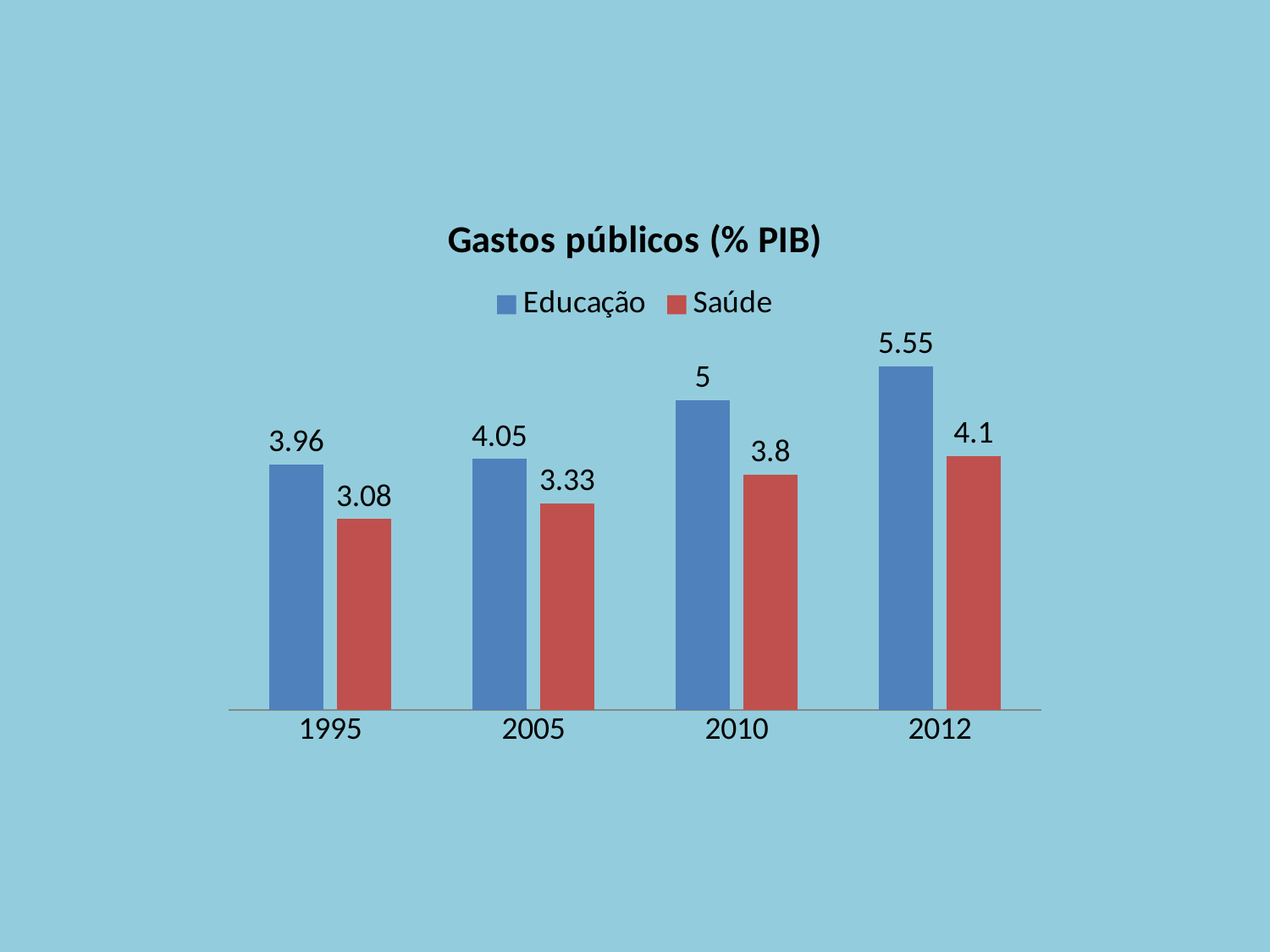
How many series does the legend list? 2 What kind of chart is shown? Bar chart In which year is the Educação value highest? 2012 In which year is the Saúde value lowest? 1995 What is the difference between the Educação values in 2010 and 1995? 1.04 What is the value for Saúde in 2010? 3.8 Which is larger in 2005, Educação or Saúde? Educação What is the value for Saúde in 1995? 3.08 How many years are shown on the x axis? 4 What is the difference between Educação and Saúde in 2012? 1.45 What is the value for Educação in 2005? 4.05 What is the value for Educação in 2012? 5.55